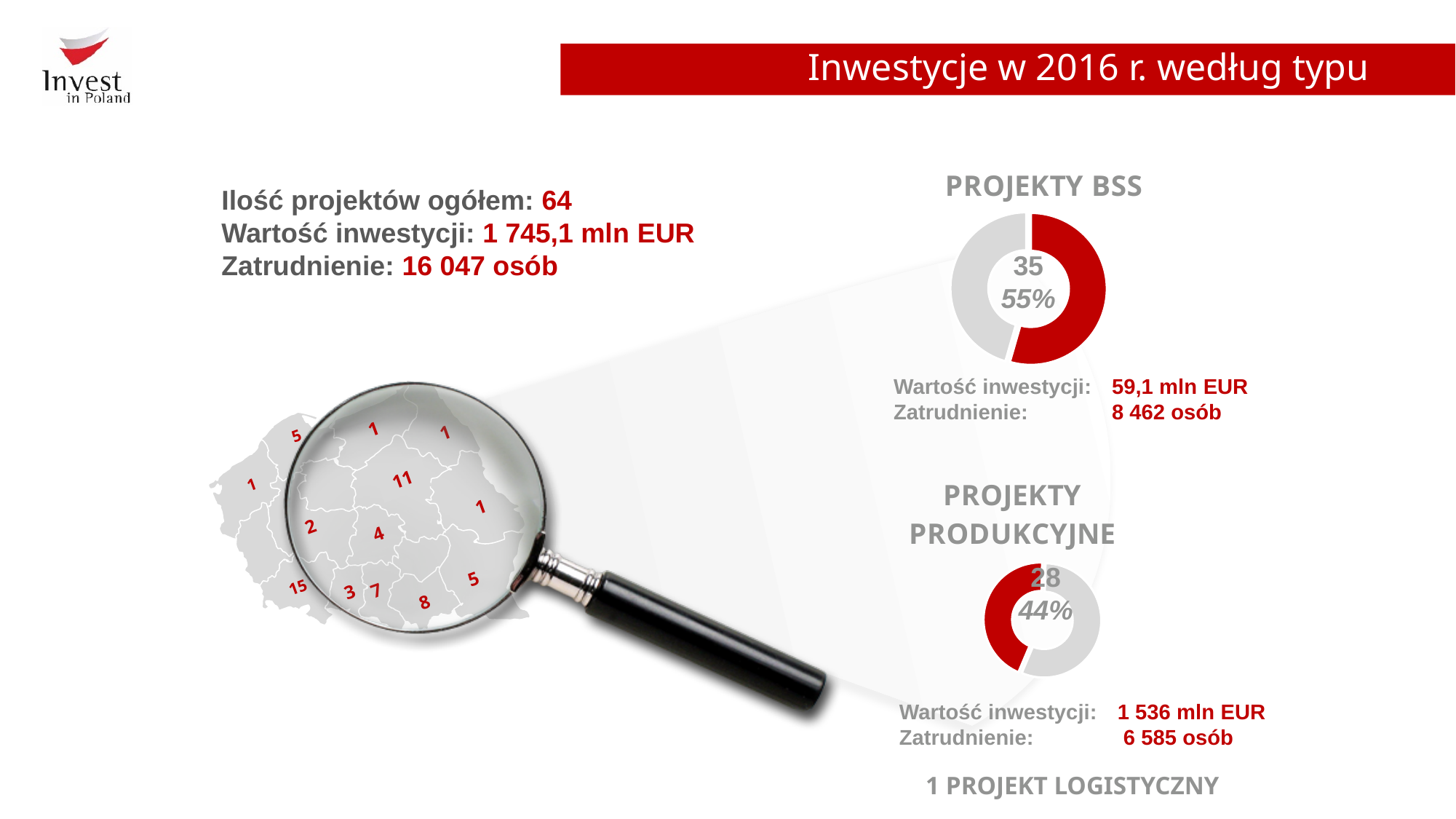
In the PROJEKTY PRODUKCYJNE chart, how many projects are shown in the centre? 28 In the PROJEKTY PRODUKCYJNE chart, what share of projects does the red segment represent? 44% Below the PROJEKTY PRODUKCYJNE chart, what is the value of 'Zatrudnienie'? 6 585 osób Below the PROJEKTY PRODUKCYJNE chart, what is the value of 'Wartość inwestycji'? 1 536 mln EUR Which has more projects, PROJEKTY BSS or PROJEKTY PRODUKCYJNE? PROJEKTY BSS In the PROJEKTY BSS chart, what share of projects does the red segment represent? 55% In the PROJEKTY BSS chart, how many projects are shown in the centre? 35 What colour is the segment representing the share in each donut chart? Red Below the PROJEKTY BSS chart, what is the value of 'Wartość inwestycji'? 59,1 mln EUR How many donut charts are shown on the slide? 2 What kind of chart is used for PROJEKTY BSS? Donut (pie) chart What is the difference in the number of projects between PROJEKTY BSS and PROJEKTY PRODUKCYJNE? 7